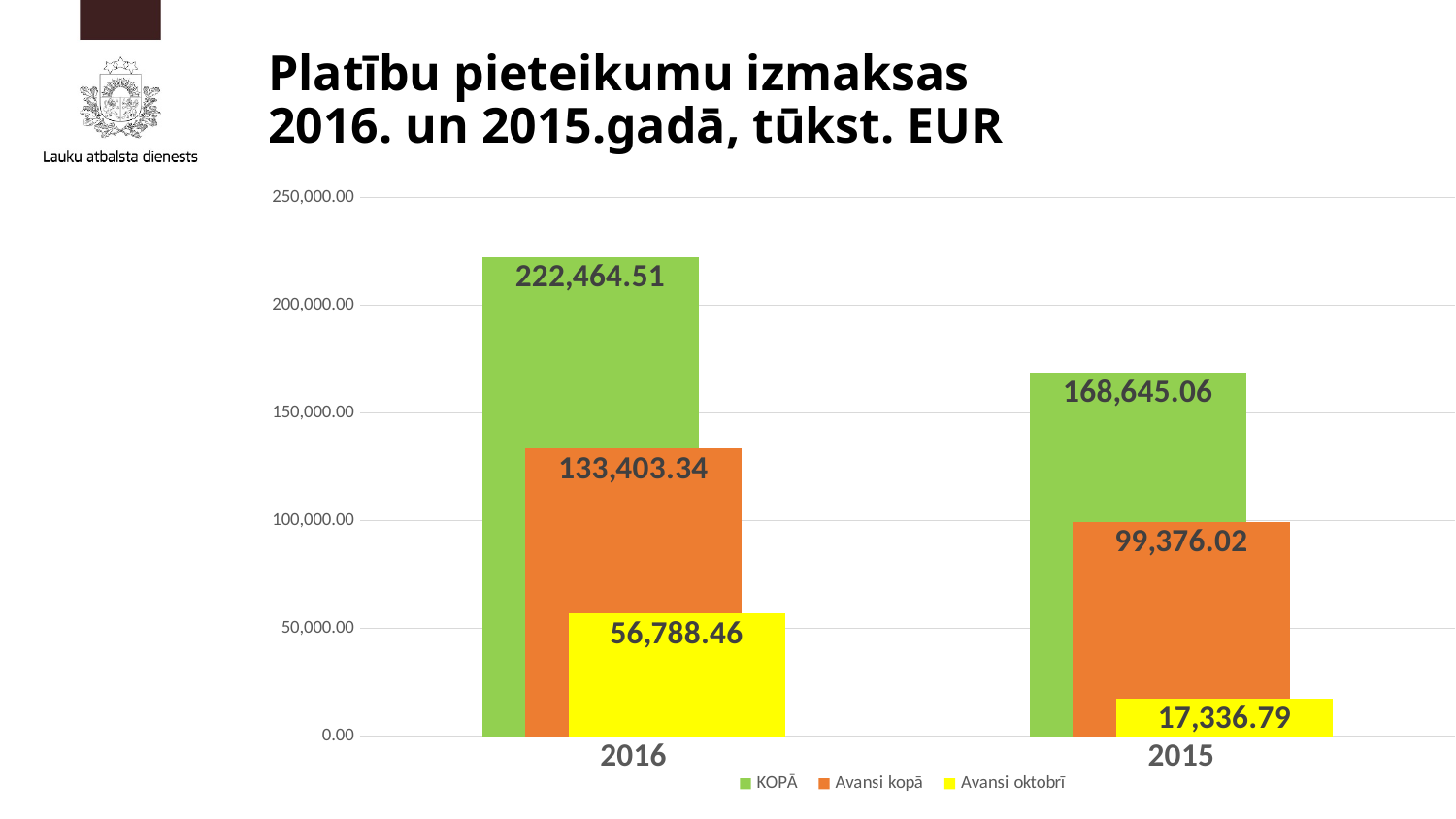
How many year categories are shown on the x axis? 2 What is the Avansi oktobrī value for 2016? 56,788.46 Is the Avansi kopā value for 2016 larger or smaller than the KOPĀ value for 2015? smaller Which series has the lowest value in 2015? Avansi oktobrī What is the difference between the KOPĀ values for 2016 and 2015? 53,819.45 What is the Avansi oktobrī value for 2015? 17,336.79 What type of chart is shown on the slide? bar chart What is the KOPĀ value for 2016? 222,464.51 How many series does the legend list? 3 Which year has the higher KOPĀ value? 2016 What is the Avansi kopā value for 2015? 99,376.02 What is the difference between the Avansi kopā values for 2016 and 2015? 34,027.32